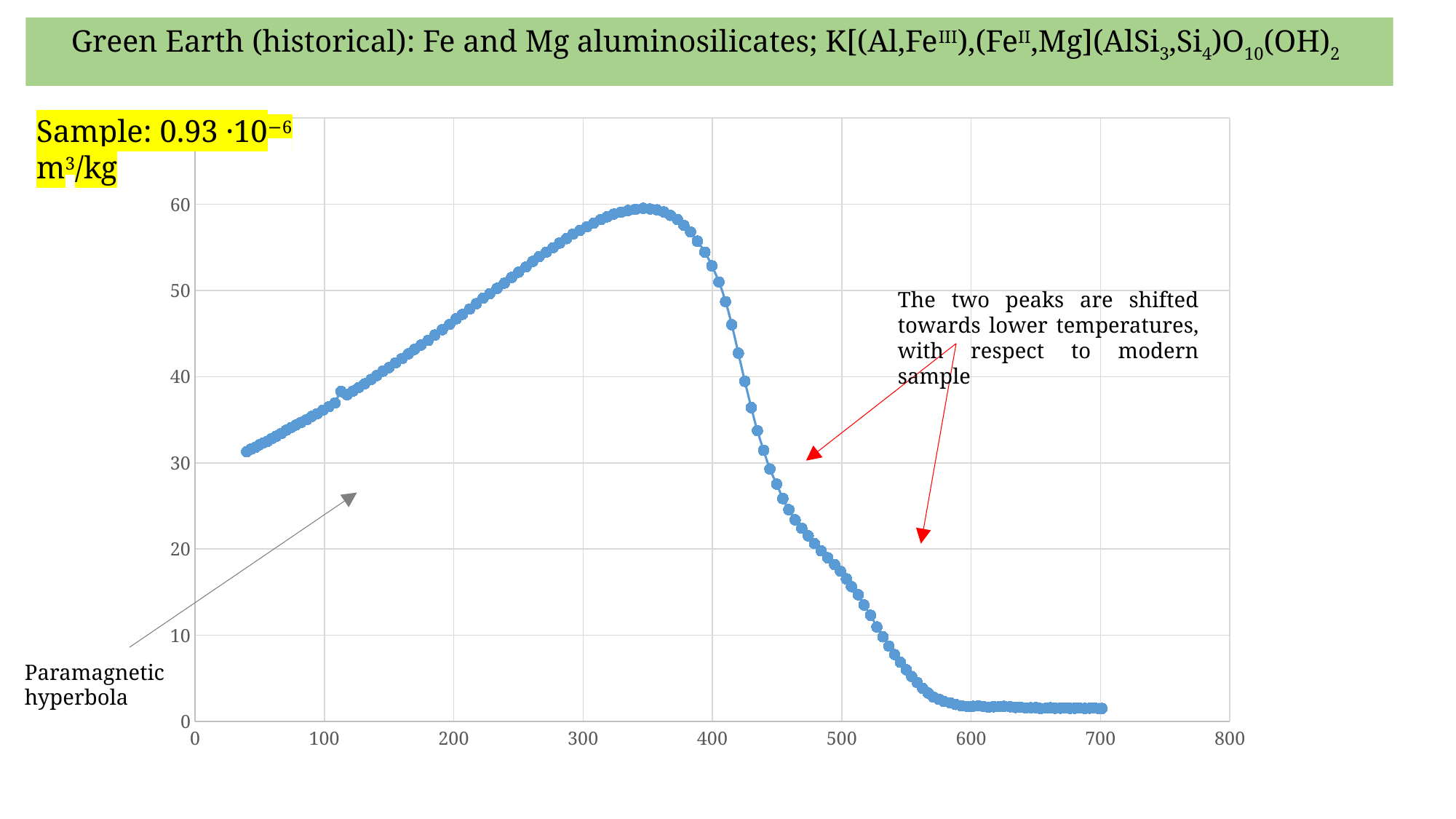
Is the plotted value at x = 550 greater or less than 10? less Do the plotted values rise or fall along the x axis between 100 and 300? rise Is the plotted value at x = 200 greater or less than 50? less Do the plotted values rise or fall along the x axis between 400 and 600? fall What is the highest tick value shown on the x axis? 800 Is the plotted value at x = 100 greater or less than 30? greater What kind of chart is shown on the slide? scatter chart What does the grey arrow annotation on the chart label the rising part of the curve as? Paramagnetic hyperbola Which is larger, the plotted value at x = 300 or at x = 600? x = 300